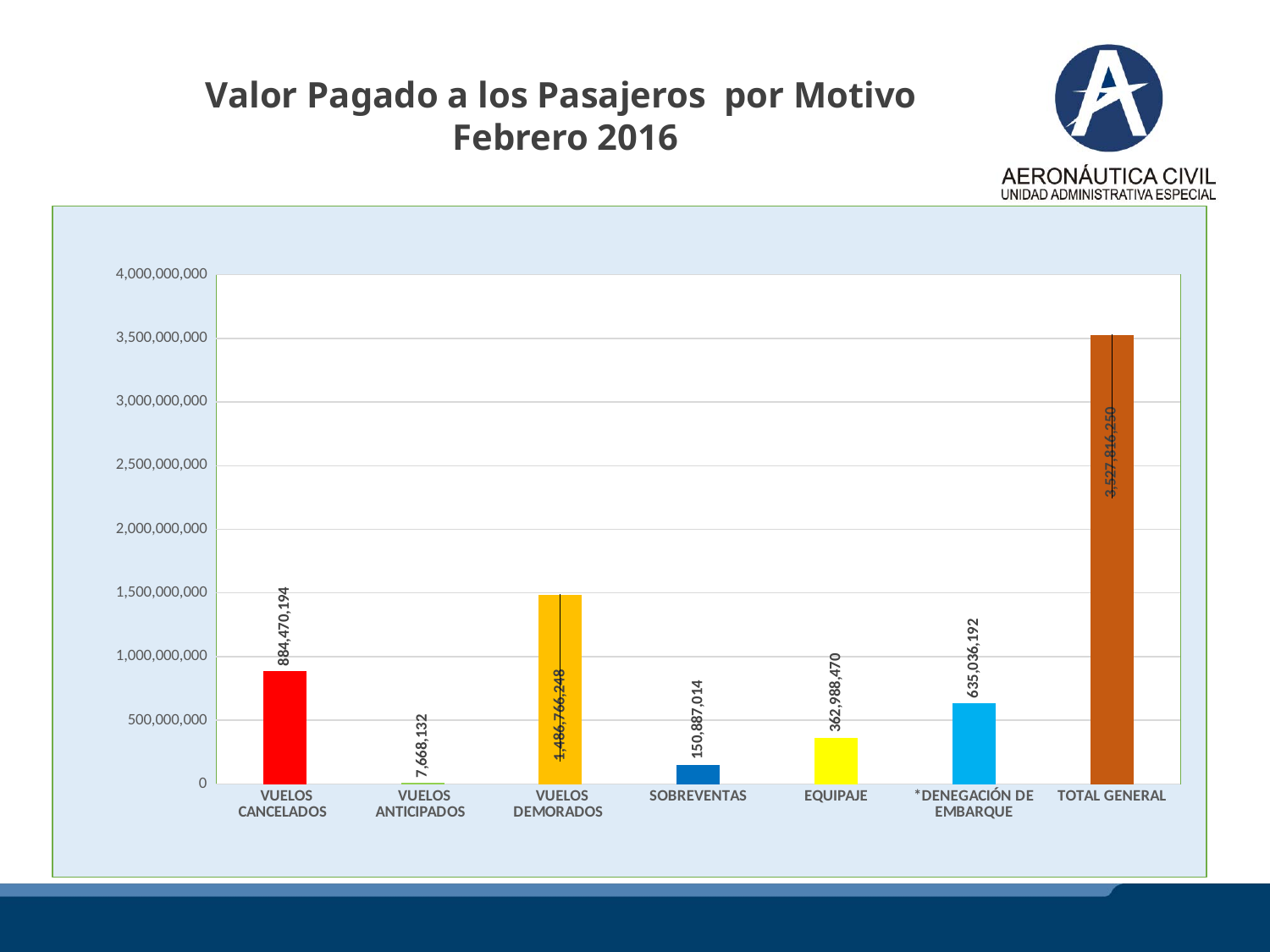
What value is shown for SOBREVENTAS? 150,887,014 What value is shown for VUELOS CANCELADOS? 884,470,194 Excluding TOTAL GENERAL, which category has the highest value? VUELOS DEMORADOS Which is larger, the value for EQUIPAJE or the value for SOBREVENTAS? EQUIPAJE What type of chart is shown on the slide? Bar chart How many categories are shown on the x axis? 7 What value is shown for VUELOS DEMORADOS? 1,486,766,248 What value is shown for *DENEGACIÓN DE EMBARQUE? 635,036,192 What is the difference between the values for VUELOS CANCELADOS and *DENEGACIÓN DE EMBARQUE? 249,434,002 What is the value of the TOTAL GENERAL bar? 3,527,816,250 Which category has the lowest value? VUELOS ANTICIPADOS Is the value for VUELOS DEMORADOS greater or less than 1,000,000,000? greater